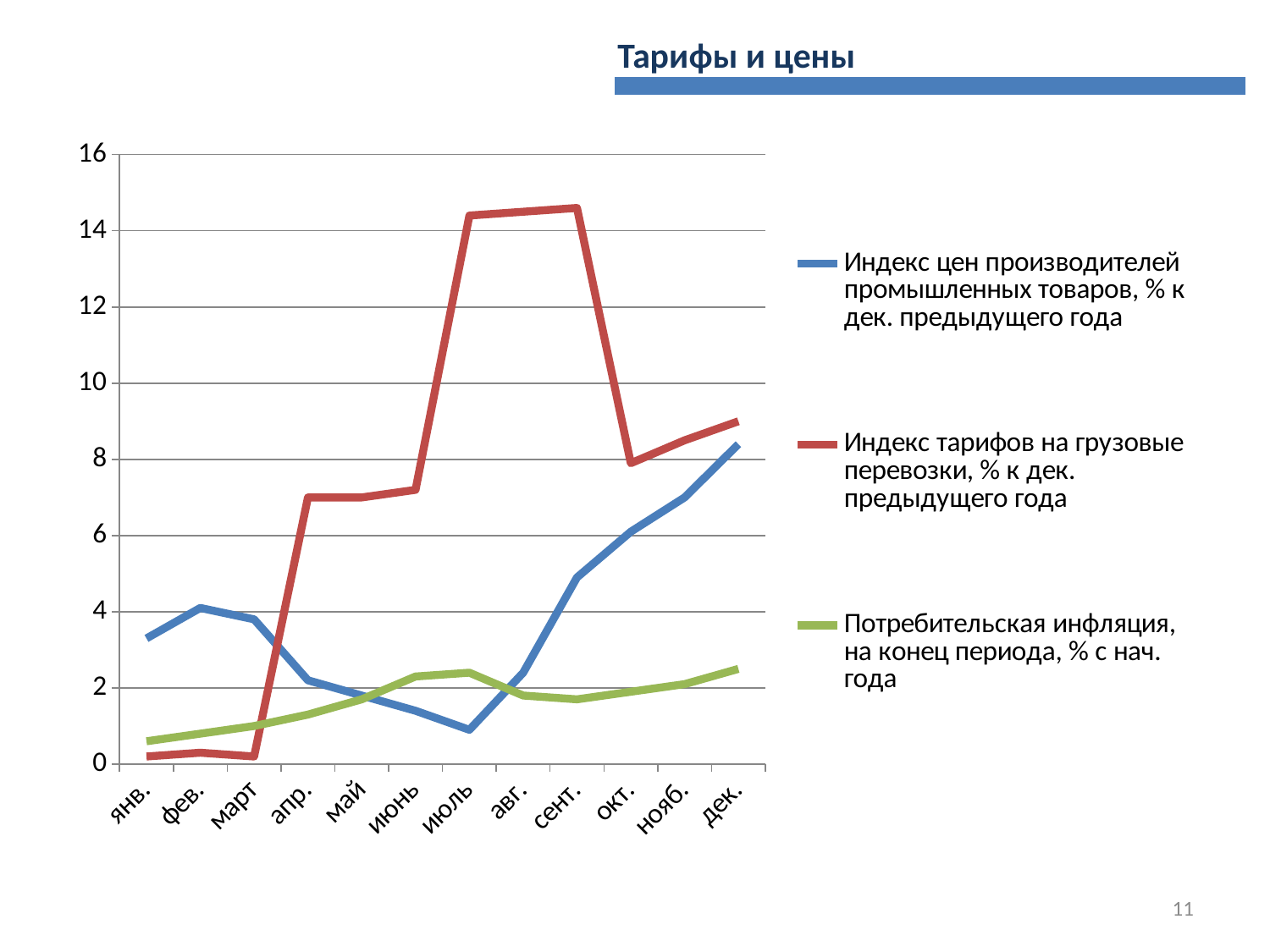
What is the title of the slide? Тарифы и цены Is the value of 'Индекс тарифов на грузовые перевозки' in июль greater or less than 12? greater Is the value of 'Потребительская инфляция' in дек. greater or less than 4? less In which month is 'Индекс цен производителей промышленных товаров' at its lowest? июль In янв., which is larger: 'Индекс цен производителей промышленных товаров' or 'Потребительская инфляция'? Индекс цен производителей промышленных товаров Which series reaches the highest value anywhere on the chart? Индекс тарифов на грузовые перевозки, % к дек. предыдущего года How many months are plotted along the x axis of the chart? 12 What kind of chart is shown on the slide? line chart Is the value of 'Индекс тарифов на грузовые перевозки' in окт. greater or less than 6? greater Does 'Потребительская инфляция' generally rise or fall from янв. to дек.? rise How many series does the chart's legend list? 3